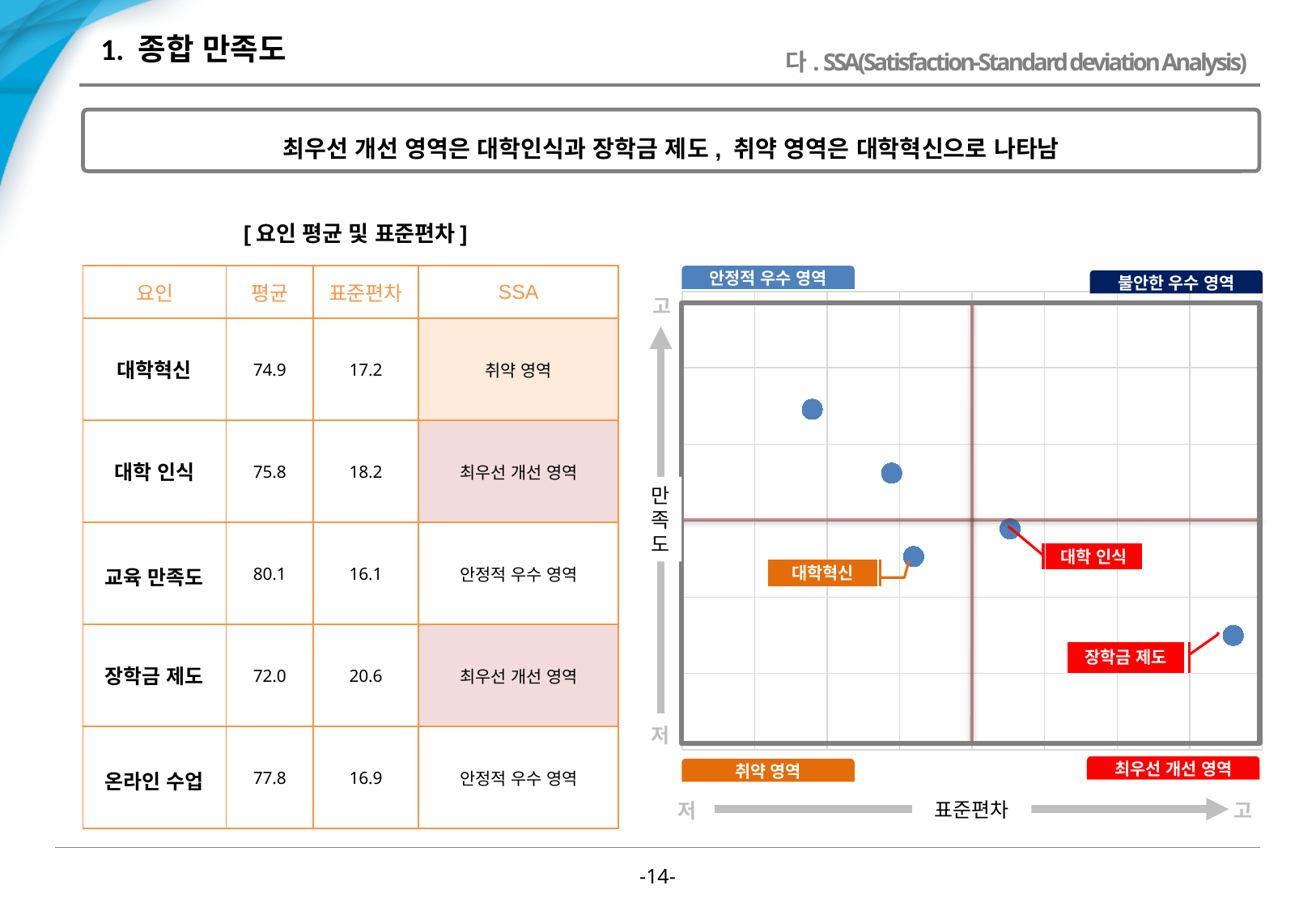
Which labelled point has the highest standard deviation (furthest right) in the scatter chart? 장학금 제도 In which SSA region does the point labelled 장학금 제도 fall? 최우선 개선 영역 Which factor has the lowest mean (평균) satisfaction? 장학금 제도 What is the difference between the mean of 교육 만족도 and the mean of 장학금 제도? 8.1 What is the mean (평균) of 대학혁신? 74.9 What is the standard deviation (표준편차) of 장학금 제도? 20.6 Which quadrant label appears at the top right of the scatter chart? 불안한 우수 영역 What is the label of the horizontal axis of the scatter chart? 표준편차 Which of the labelled points, 대학 인식 or 대학혁신, has the larger standard deviation? 대학 인식 In which SSA region does the point labelled 대학혁신 fall? 취약 영역 What kind of chart is shown on the right side of the slide? scatter chart How many data points are plotted in the scatter chart? 5